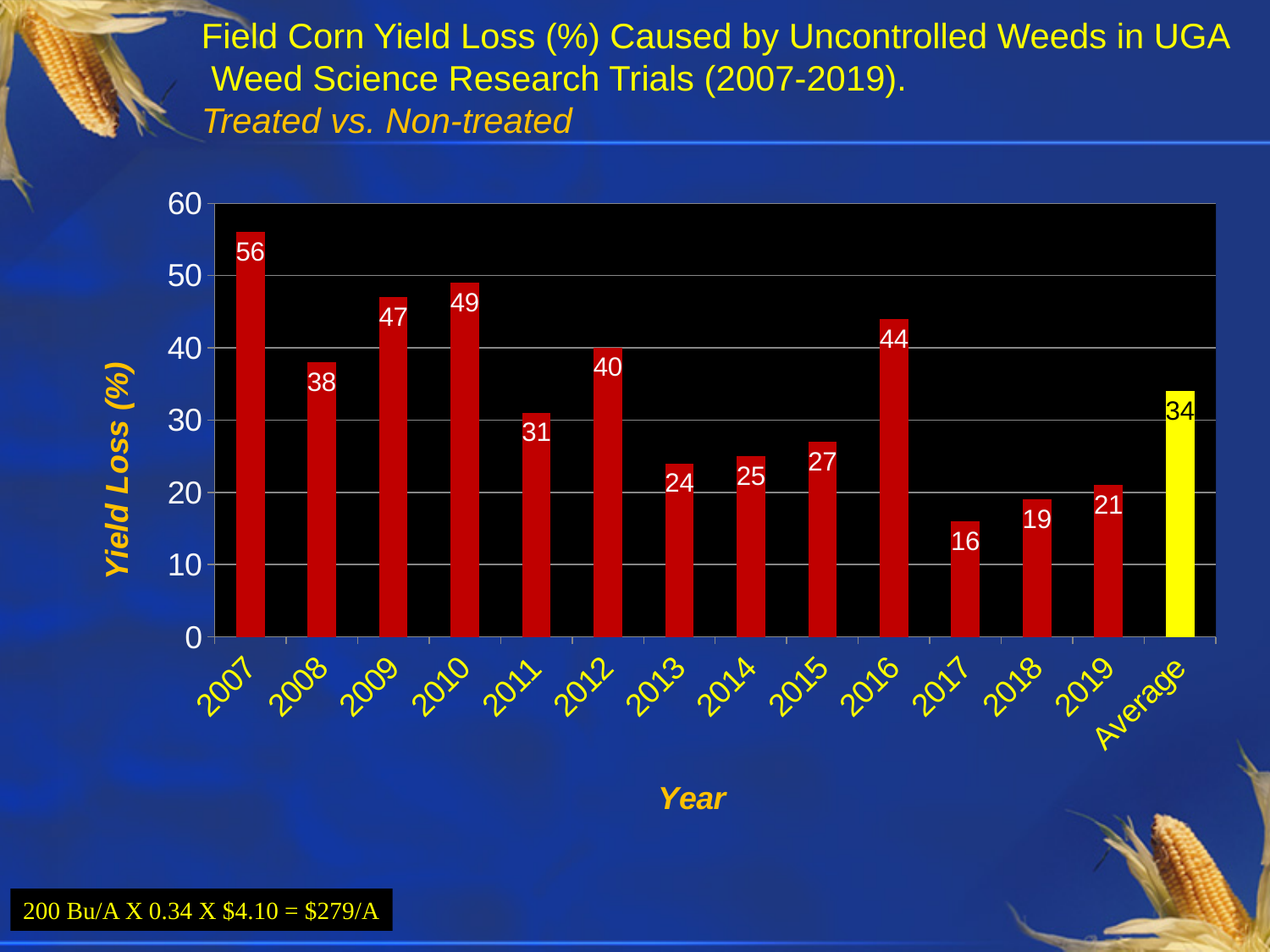
How many bars are plotted on the chart, including the Average bar? 14 What is the difference between the yield loss in 2010 and in 2011? 18 What colour is the Average bar? Yellow What is the yield loss value for 2016? 44 What kind of chart is shown on the slide? Bar chart What is the yield loss value for 2007? 56 Which year has the lowest yield loss? 2017 Which year has the highest yield loss? 2007 What is the label of the y axis? Yield Loss (%) Do the yield loss values generally rise or fall from 2016 to 2017? Fall Which has a larger yield loss, 2009 or 2012? 2009 What is the value shown for the Average bar? 34